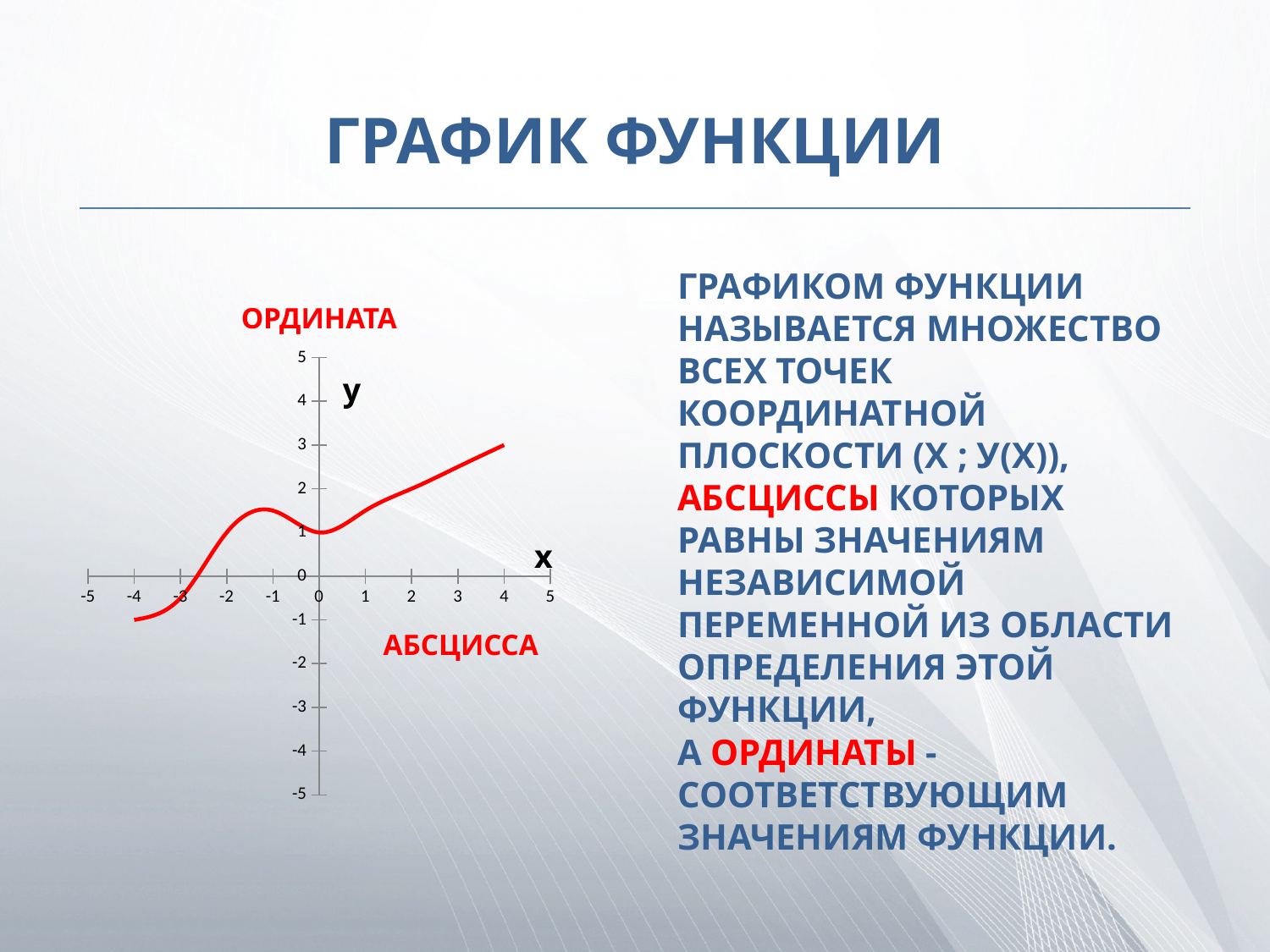
Is the value of the function at x = 2 greater or less than 1? greater Is the value of the function at x = 1 greater or less than 2? less Is the value of the function at x = -4 greater or less than 0? less Which is larger: the value of the function at x = 4 or at x = 0? x = 4 What is the highest value labeled on the y axis? 5 What colour is the plotted curve? red What kind of chart is shown on the slide? line chart Does the curve rise or fall as x goes from 1 to 4? rise Which is larger: the value of the function at x = -4 or at x = -1? x = -1